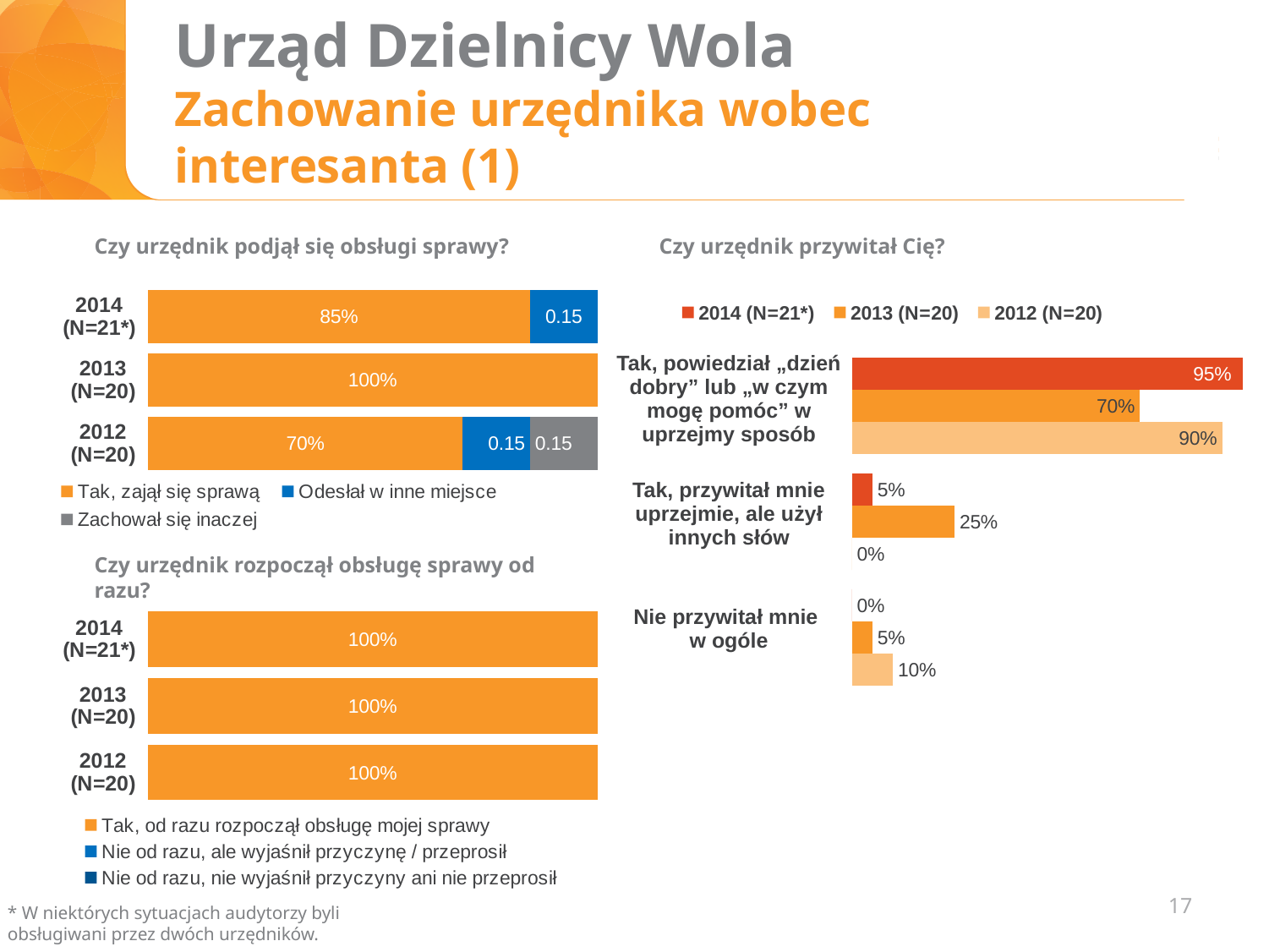
In the chart 'Czy urzędnik rozpoczął obsługę sprawy od razu?', what is the value for 2013 (N=20)? 100% In the chart 'Czy urzędnik przywitał Cię?', what is the difference between the 2014 and 2013 values for 'Tak, powiedział „dzień dobry” lub „w czym mogę pomóc” w uprzejmy sposób'? 25% In the chart 'Czy urzędnik przywitał Cię?', which year has the highest value for 'Tak, powiedział „dzień dobry” lub „w czym mogę pomóc” w uprzejmy sposób'? 2014 (N=21*) In the chart 'Czy urzędnik podjął się obsługi sprawy?', what is the 'Tak, zajął się sprawą' value for 2012 (N=20)? 70% In the chart 'Czy urzędnik podjął się obsługi sprawy?', what is the 'Tak, zajął się sprawą' value for 2014 (N=21*)? 85% How many series does the legend of the chart 'Czy urzędnik przywitał Cię?' list? 3 In the chart 'Czy urzędnik przywitał Cię?', what is the 2012 (N=20) value for 'Nie przywitał mnie w ogóle'? 10% In the chart 'Czy urzędnik przywitał Cię?', what is the 2013 (N=20) value for 'Tak, przywitał mnie uprzejmie, ale użył innych słów'? 25% What kind of chart is 'Czy urzędnik rozpoczął obsługę sprawy od razu?'? Bar chart In the chart 'Czy urzędnik przywitał Cię?', what is the 2014 (N=21*) value for 'Tak, powiedział „dzień dobry” lub „w czym mogę pomóc” w uprzejmy sposób'? 95% In the chart 'Czy urzędnik podjął się obsługi sprawy?', which year has the highest 'Tak, zajął się sprawą' value? 2013 (N=20) In the chart 'Czy urzędnik przywitał Cię?', which year has the lowest value for 'Tak, powiedział „dzień dobry” lub „w czym mogę pomóc” w uprzejmy sposób'? 2013 (N=20)